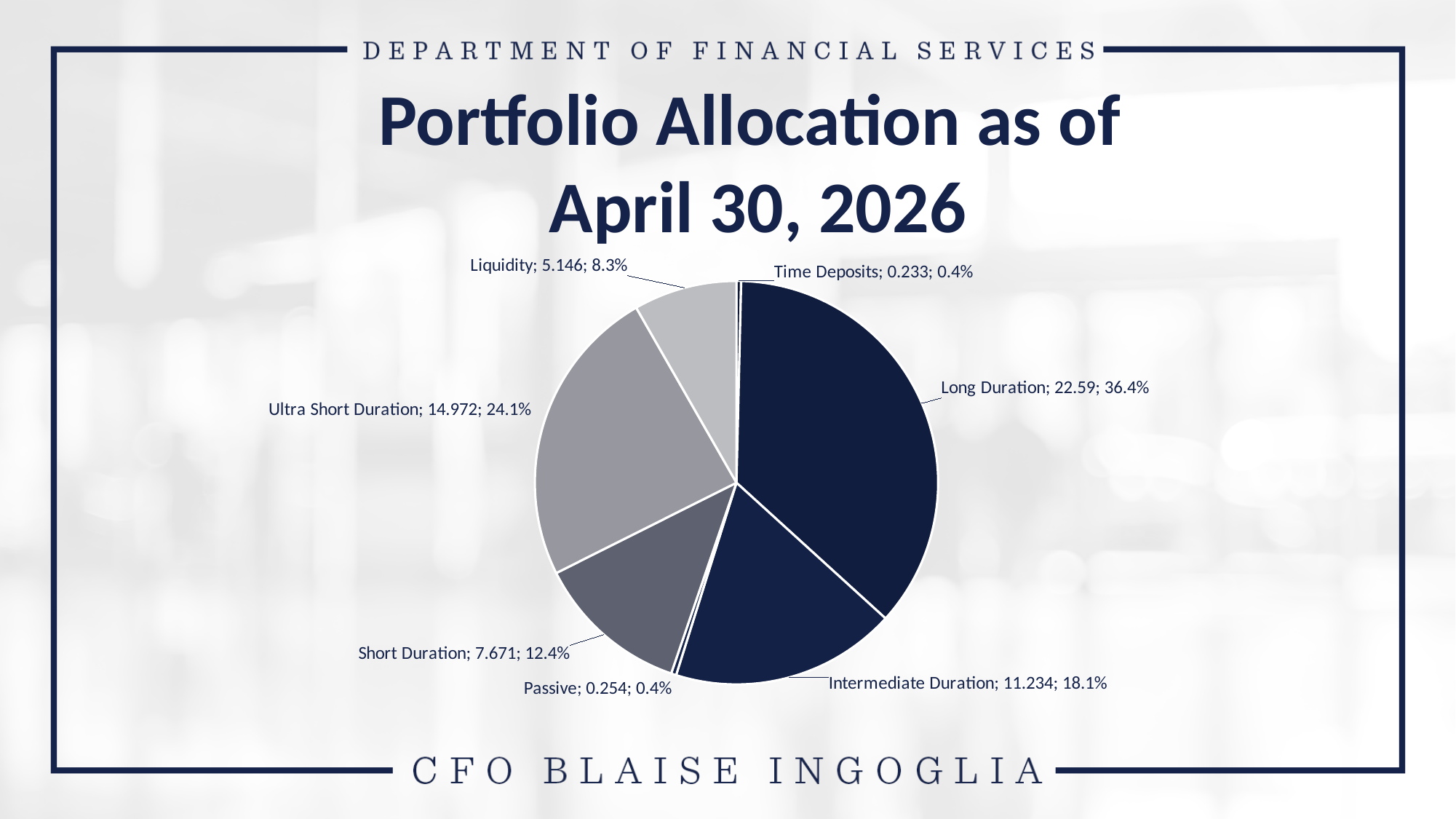
Which category has the largest slice of the pie? Long Duration What is the title of the chart on the slide? Portfolio Allocation as of April 30, 2026 How many slices does the pie chart have? 7 What value is shown for Intermediate Duration? 11.234 What percentage share does Liquidity have? 8.3% What is the combined percentage share of Long Duration and Intermediate Duration? 54.5% What percentage share does Long Duration have in the pie chart? 36.4% What is the difference in percentage share between Long Duration and Ultra Short Duration? 12.3 percentage points What value is shown for Passive? 0.254 What kind of chart is shown on the slide? Pie chart Which is larger, Short Duration or Ultra Short Duration? Ultra Short Duration What value is shown for Ultra Short Duration? 14.972